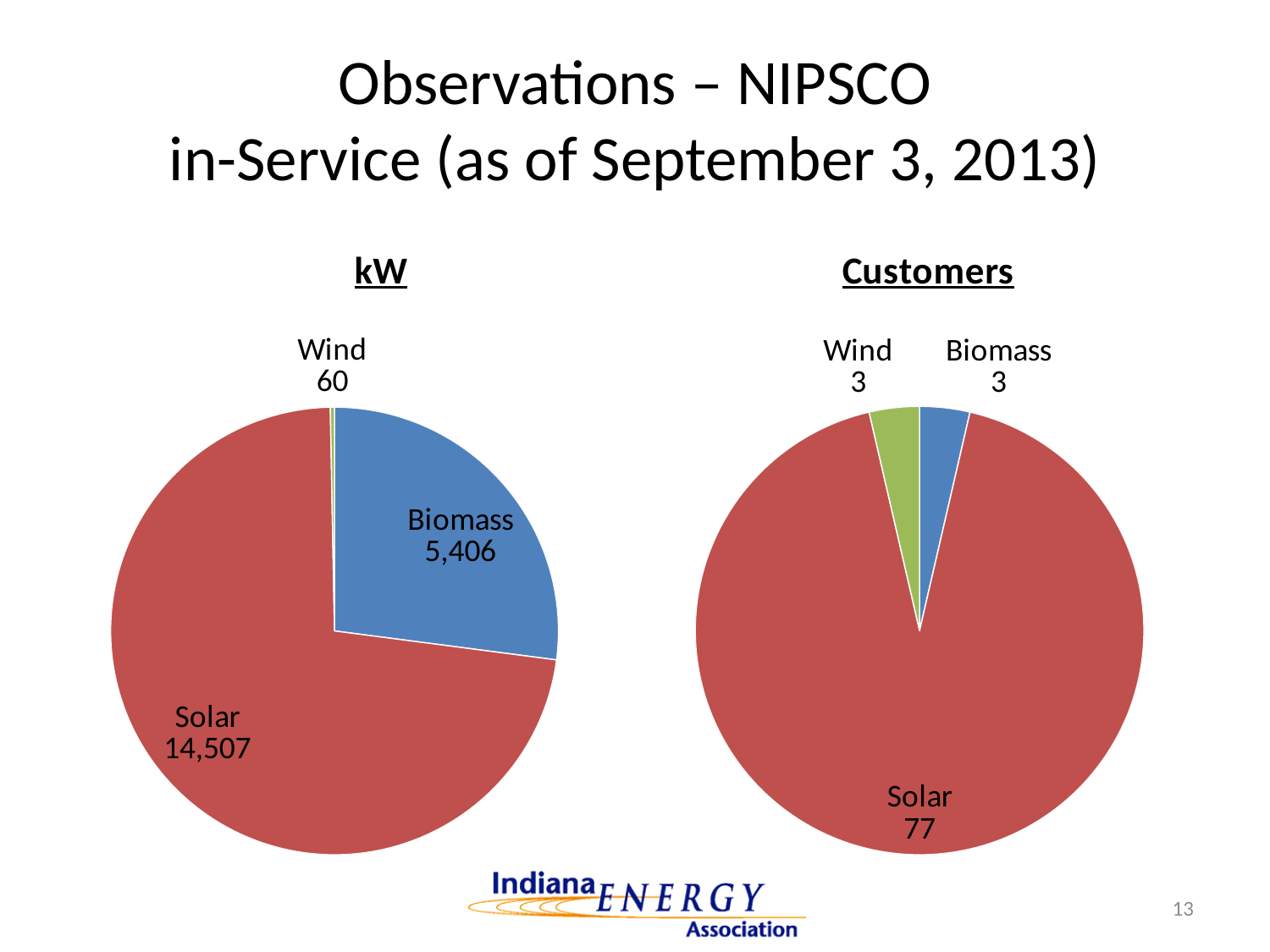
In the kW pie chart, which category has the smallest slice? Wind In the kW pie chart, which is larger, Biomass or Wind? Biomass In the kW pie chart, which category has the largest slice? Solar How many categories are shown in the Customers pie chart? 3 In the kW pie chart, what is the value for Solar? 14,507 What type of chart is used for the kW data? Pie chart In the kW pie chart, what is the value for Wind? 60 In the Customers pie chart, what is the difference between the Solar and Biomass customer counts? 74 In the Customers pie chart, how many customers does Solar have? 77 In the kW pie chart, what is the difference between the Solar and Biomass values? 9,101 In the Customers pie chart, how many customers does Wind have? 3 In the kW pie chart, what is the value for Biomass? 5,406